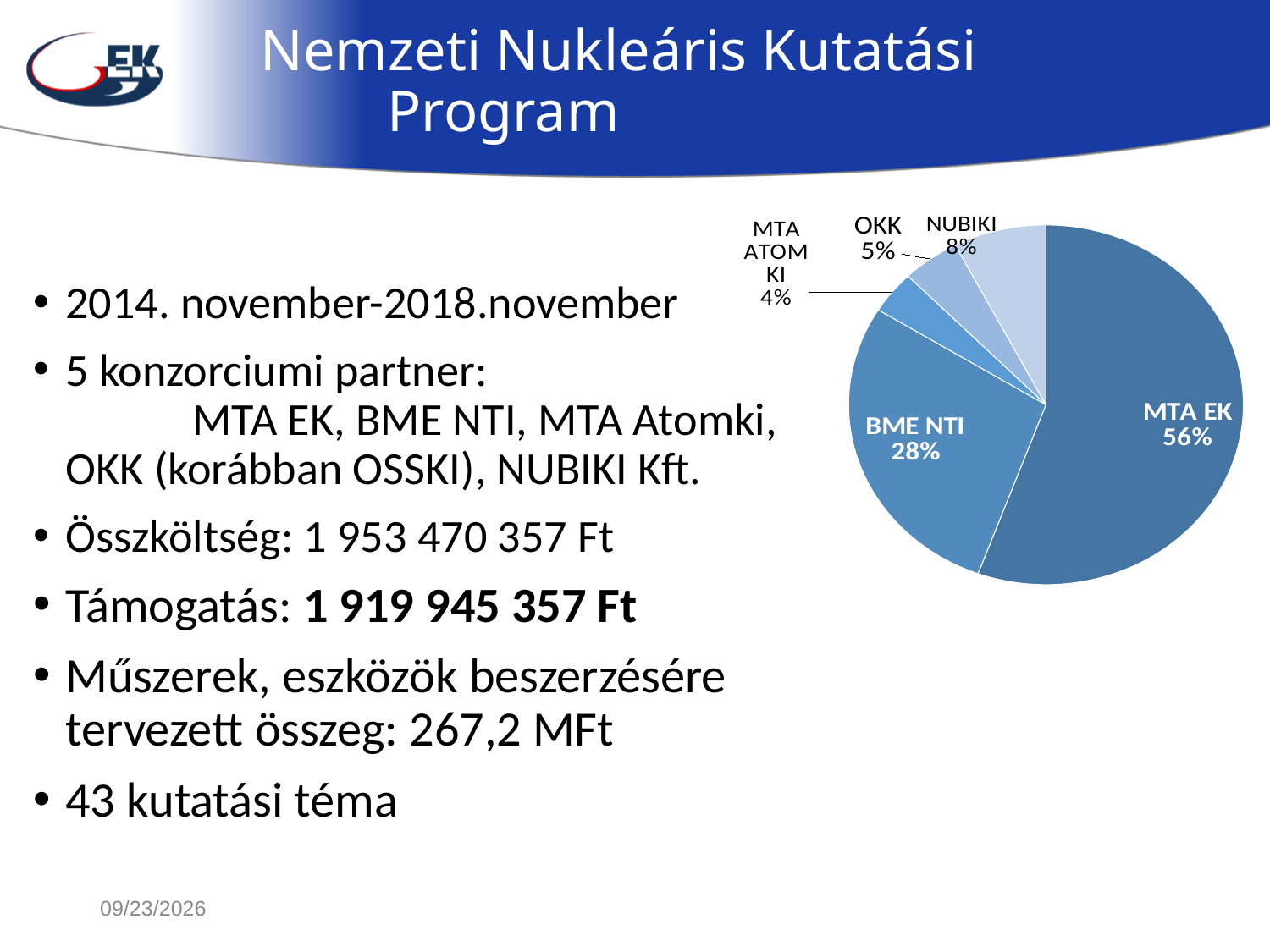
What kind of chart is shown on the slide? pie chart What is the difference in percentage points between the MTA EK and BME NTI slices? 28 How many slices does the pie chart have? 5 What share of the pie does MTA ATOMKI have? 4% What is the combined share of the OKK and MTA ATOMKI slices? 9% What share of the pie does OKK have? 5% Which slice of the pie chart is the smallest? MTA ATOMKI Which slice of the pie chart is the largest? MTA EK Which slice is larger, NUBIKI or OKK? NUBIKI What share of the pie does MTA EK have? 56%